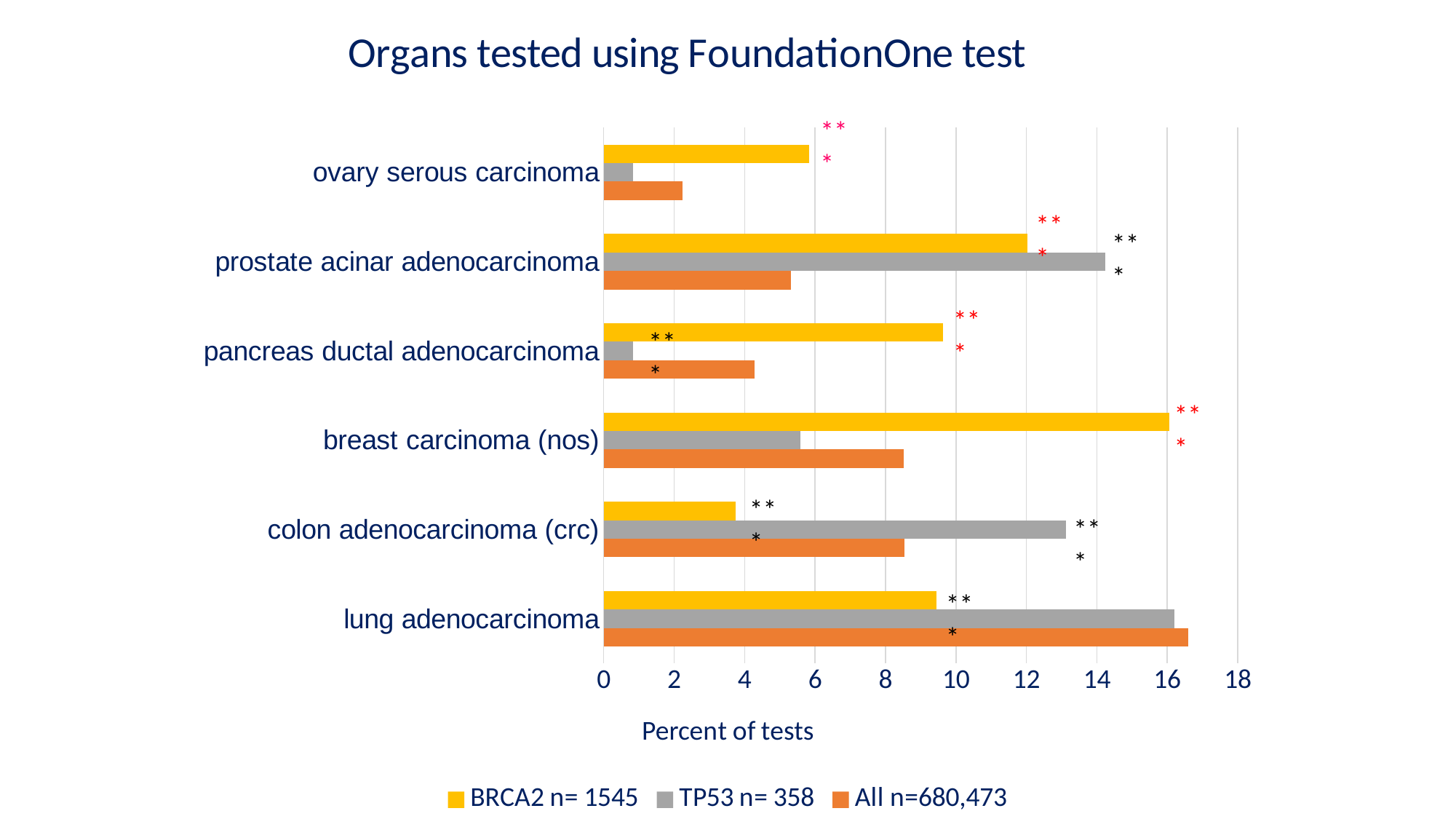
Is the TP53 value for colon adenocarcinoma (crc) greater or less than 12? greater Which category has the highest TP53 value? lung adenocarcinoma What is the label of the x axis? Percent of tests How many organ/cancer categories are plotted on the chart? 6 Which category has the lowest value for the All series? ovary serous carcinoma What kind of chart is shown on the slide? bar chart How many series does the legend list? 3 Which category has the lowest BRCA2 value? colon adenocarcinoma (crc) Which category has the highest BRCA2 value? breast carcinoma (nos) Is the BRCA2 value for breast carcinoma (nos) greater or less than 14? greater For prostate acinar adenocarcinoma, which series has the larger value, BRCA2 or TP53? TP53 Is the All value for ovary serous carcinoma greater or less than 4? less